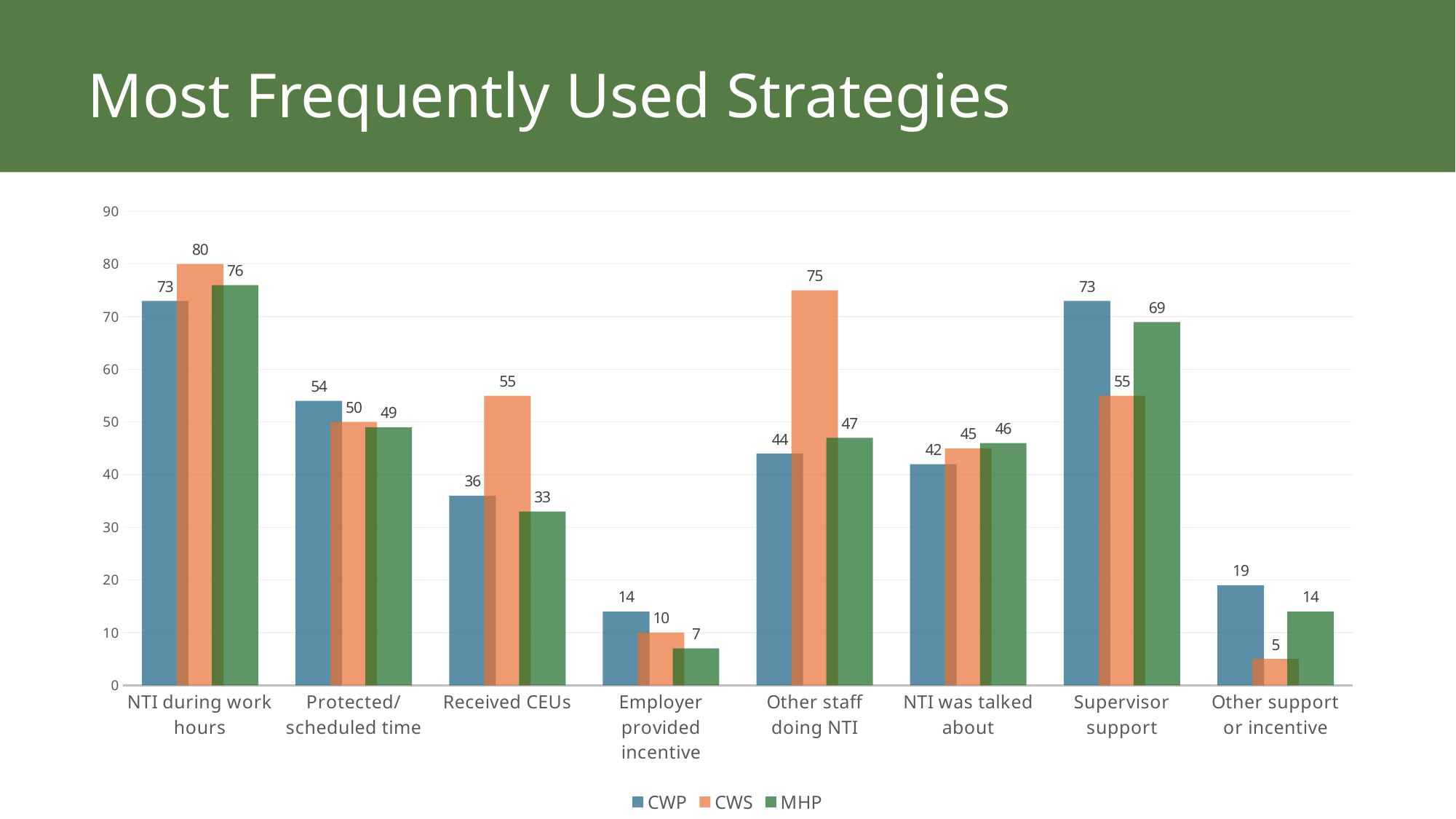
What is the difference between the CWS and MHP values for "Other staff doing NTI"? 28 Which category has the highest CWS value? NTI during work hours How many categories are shown on the x axis? 8 Is the CWP value for "Supervisor support" greater or less than 70? greater Which is larger for "Received CEUs": the CWP value or the CWS value? CWS What kind of chart is shown on the slide? Bar chart What is the title of the slide? Most Frequently Used Strategies Which category has the lowest MHP value? Employer provided incentive What is the CWS value for "Other staff doing NTI"? 75 How many series does the legend list? 3 What is the MHP value for "Supervisor support"? 69 What is the CWP value for "Employer provided incentive"? 14